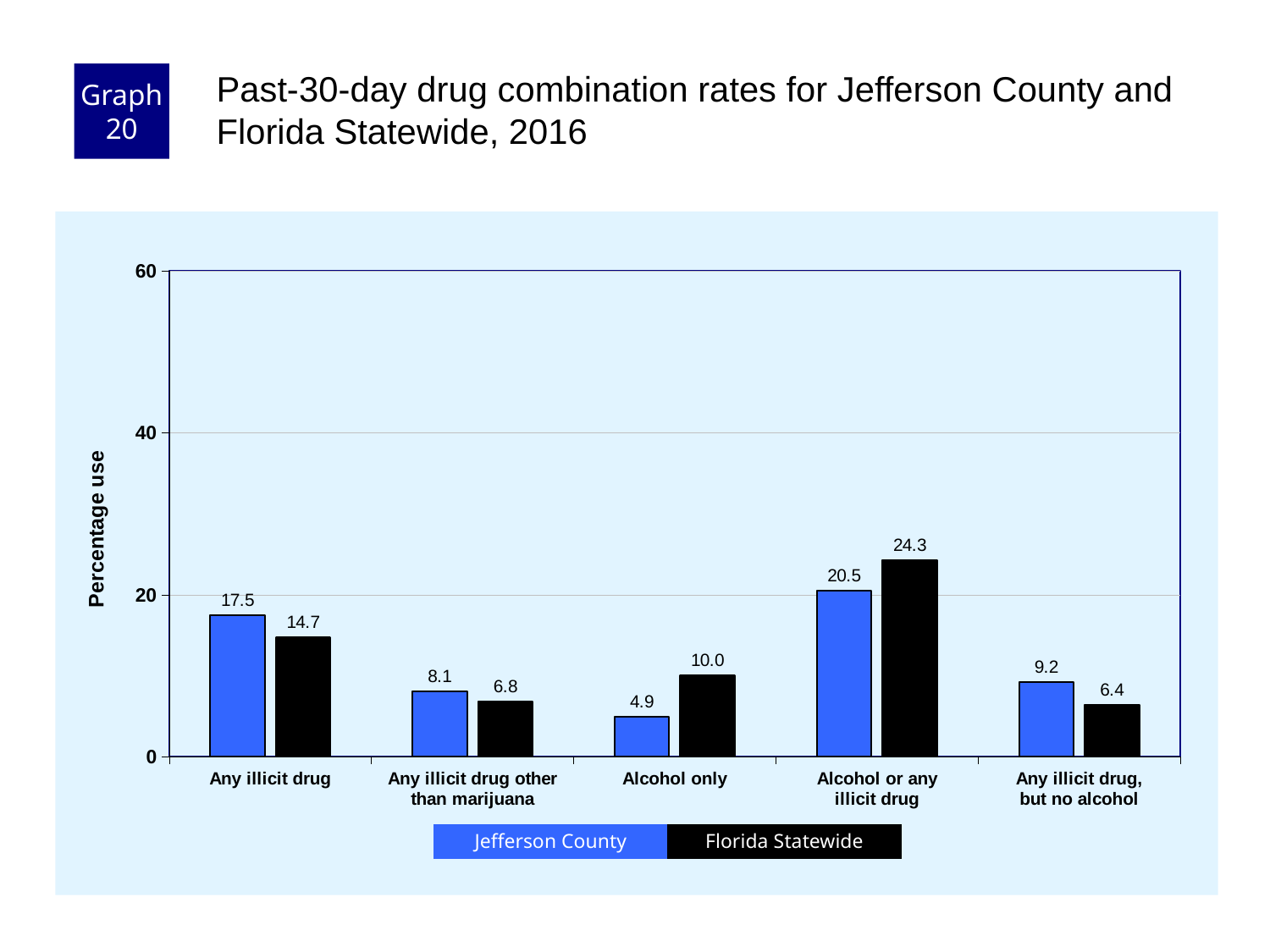
What is the difference between the Florida Statewide and Jefferson County values for Alcohol or any illicit drug? 3.8 How many series does the legend list? 2 Which is larger for Alcohol only: Jefferson County or Florida Statewide? Florida Statewide What is the Florida Statewide value for Alcohol only? 10.0 Which category has the highest Florida Statewide value? Alcohol or any illicit drug Which category has the lowest Jefferson County value? Alcohol only What is the Jefferson County value for Any illicit drug, but no alcohol? 9.2 How many categories are shown on the x axis? 5 What is the difference between the Jefferson County and Florida Statewide values for Any illicit drug? 2.8 What is the Jefferson County value for Any illicit drug? 17.5 What kind of chart is shown on the slide? Bar chart Is the Florida Statewide value for Alcohol or any illicit drug greater or less than 20? greater